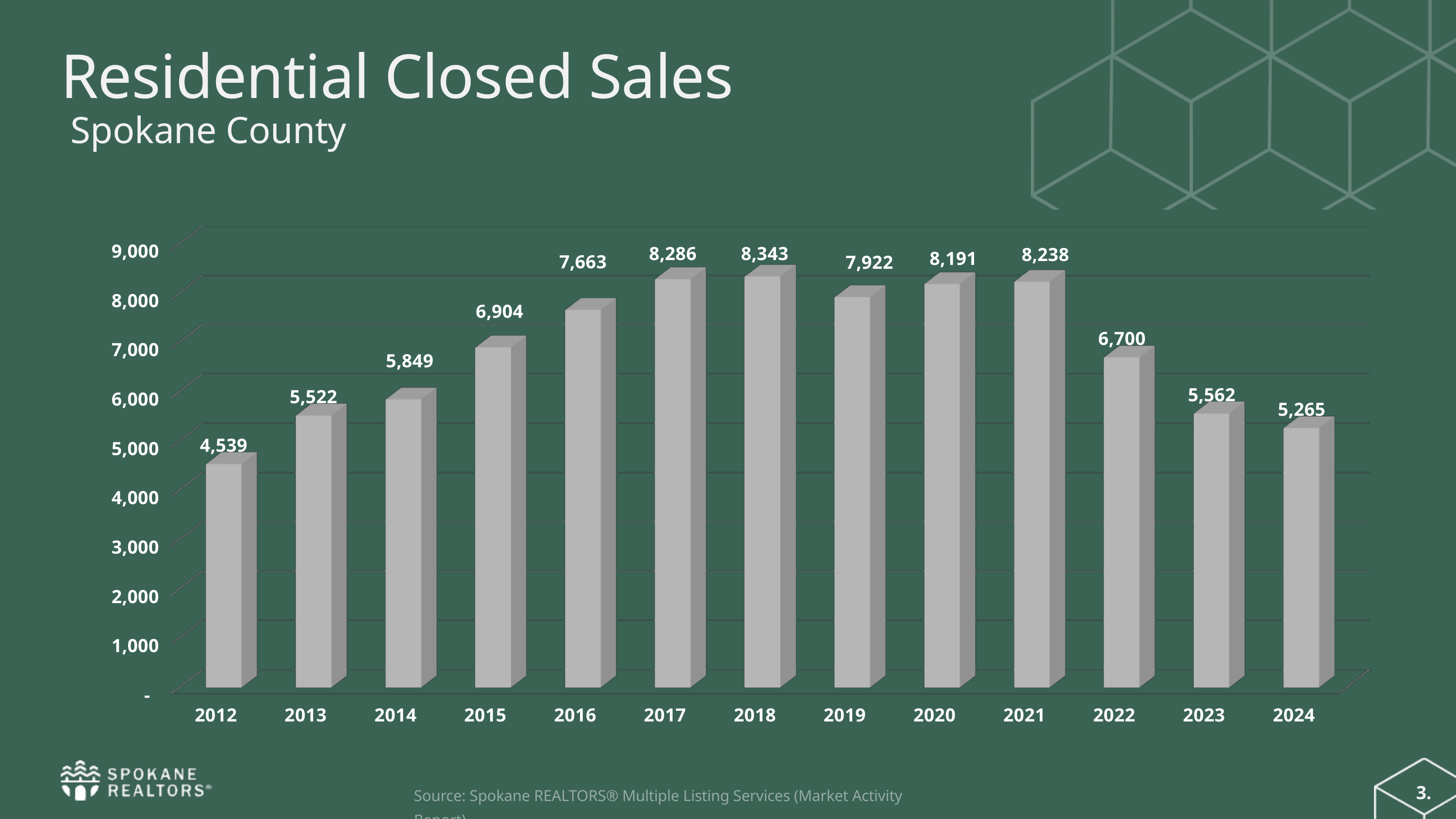
How many years are shown on the chart? 13 Which year had the lowest number of residential closed sales? 2012 What is the difference in closed sales between 2018 and 2024? 3,078 Is the value for 2015 greater or less than 7,000? less What was the number of residential closed sales in 2024? 5,265 What is the difference in closed sales between 2022 and 2023? 1,138 Which year had the highest number of residential closed sales? 2018 What was the number of residential closed sales in Spokane County in 2012? 4,539 What kind of chart is shown on the slide? Bar chart Which year had more closed sales, 2016 or 2019? 2019 What was the number of residential closed sales in 2021? 8,238 Did residential closed sales rise or fall from 2021 to 2024? Fall